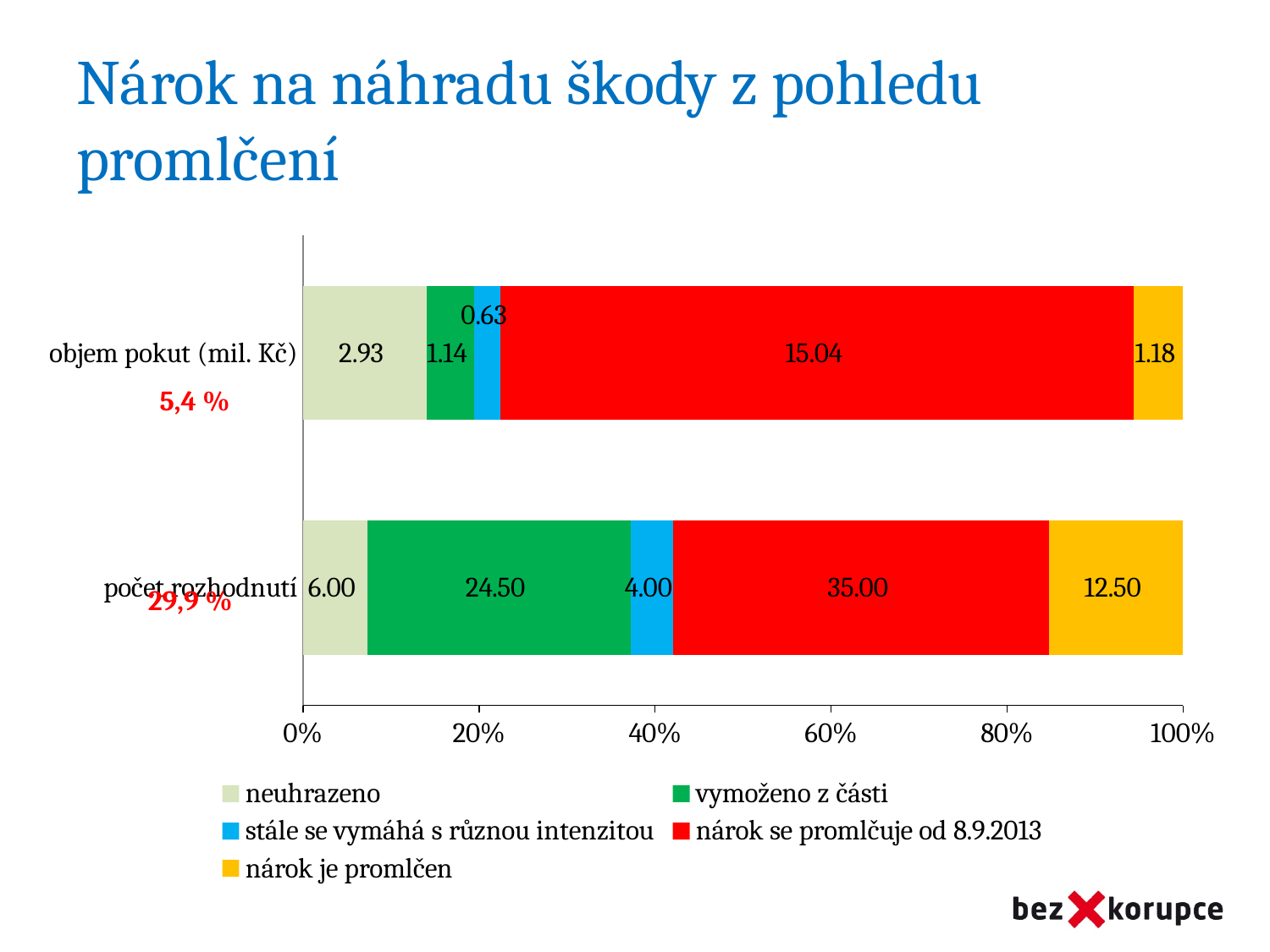
What is the value of 'vymoženo z části' for 'počet rozhodnutí'? 24.50 Which is larger for 'objem pokut (mil. Kč)': 'neuhrazeno' or 'nárok je promlčen'? neuhrazeno What is the value of 'nárok se promlčuje od 8.9.2013' for 'objem pokut (mil. Kč)'? 15.04 What is the value of 'stále se vymáhá s různou intenzitou' for 'objem pokut (mil. Kč)'? 0.63 How many categories are plotted on the chart? 2 Which series has the highest value for 'počet rozhodnutí'? nárok se promlčuje od 8.9.2013 What is the difference between 'nárok se promlčuje od 8.9.2013' and 'vymoženo z části' for 'počet rozhodnutí'? 10.50 Which series has the lowest value for 'objem pokut (mil. Kč)'? stále se vymáhá s různou intenzitou What is the total of the 'počet rozhodnutí' bar? 82.00 What kind of chart is shown on the slide? stacked bar chart What is the value of 'nárok je promlčen' for 'počet rozhodnutí'? 12.50 How many series does the legend list? 5